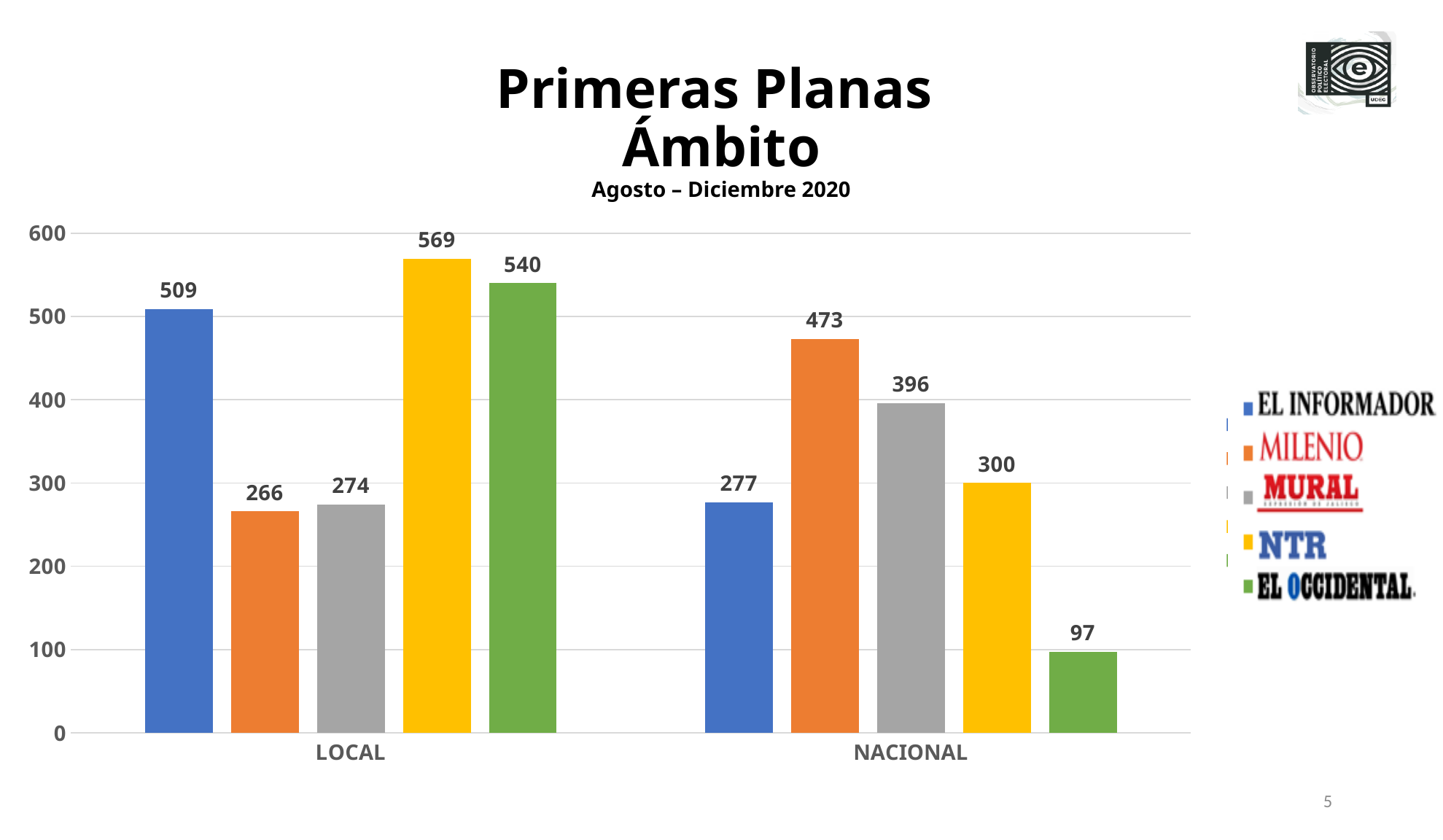
What is the value for NTR in the LOCAL category? 569 How many categories are shown on the x axis? 2 What period does the chart subtitle indicate? Agosto – Diciembre 2020 How many series does the legend list? 5 What kind of chart is shown on the slide? Bar chart Which is larger for Mural: the LOCAL value or the NACIONAL value? NACIONAL Which newspaper has the lowest value in the NACIONAL category? El Occidental What is the difference between El Informador's LOCAL and NACIONAL values? 232 What is the value for El Occidental in the NACIONAL category? 97 Is the value for El Occidental in the LOCAL category greater or less than 500? greater What is the value for Milenio in the NACIONAL category? 473 Which newspaper has the highest value in the LOCAL category? NTR